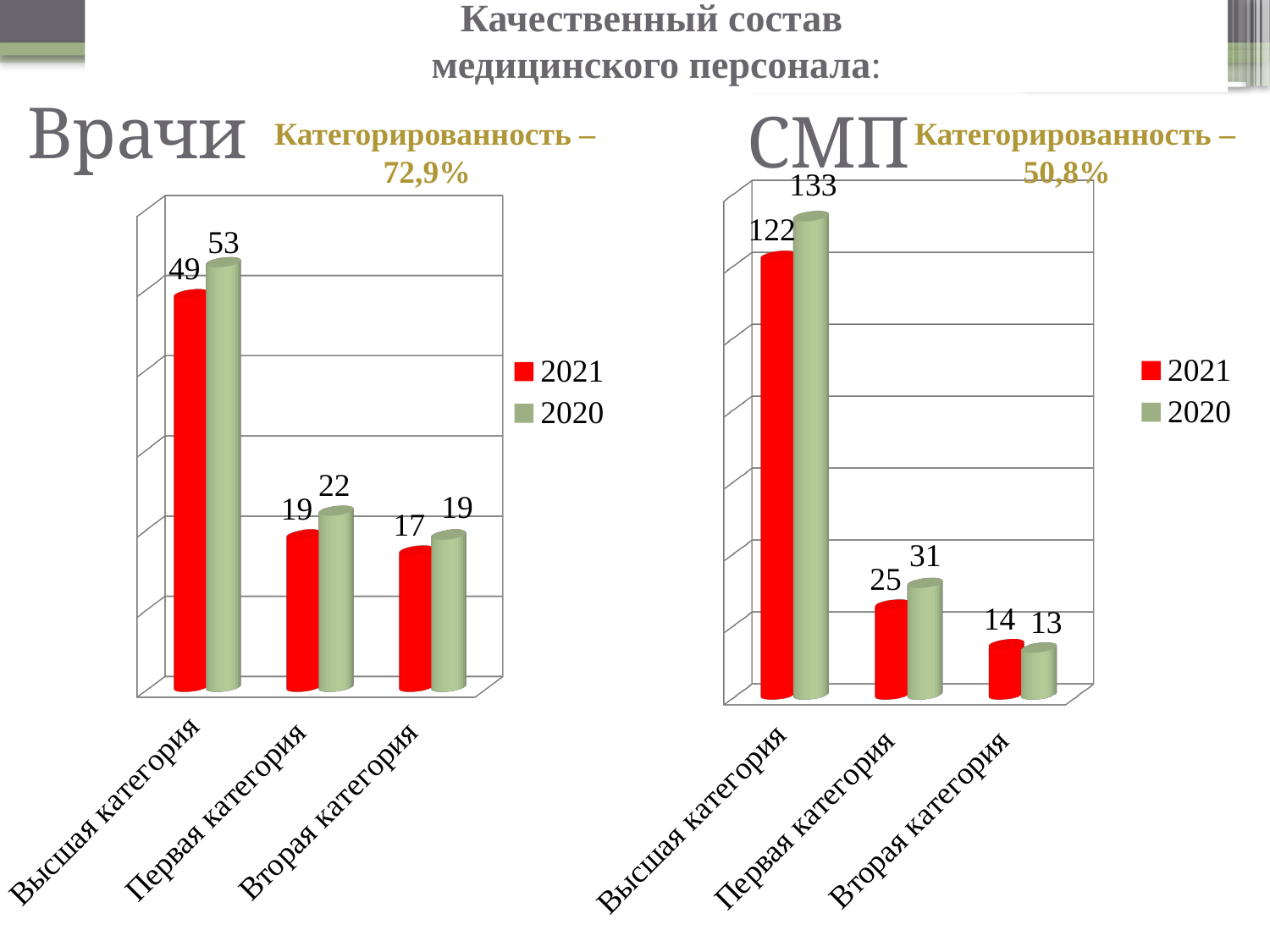
In the СМП chart, what is the difference between the 2020 and 2021 values for Высшая категория? 11 In the СМП chart, what is the value for Вторая категория in 2021? 14 How many series does the legend of the СМП chart list? 2 In the СМП chart, what is the value for Высшая категория in 2020? 133 In the Врачи chart, what is the difference between the 2020 and 2021 values for Высшая категория? 4 In the Врачи chart, what is the value for Первая категория in 2020? 22 In the СМП chart, which is larger for Первая категория: the 2021 value or the 2020 value? 2020 What kind of chart is the Врачи chart? Bar chart In the Врачи chart, which category has the lowest value for 2020? Вторая категория In the СМП chart, which category has the highest value for 2021? Высшая категория In the Врачи chart, what is the value for Высшая категория in 2021? 49 How many categories are shown on the x axis of the Врачи chart? 3